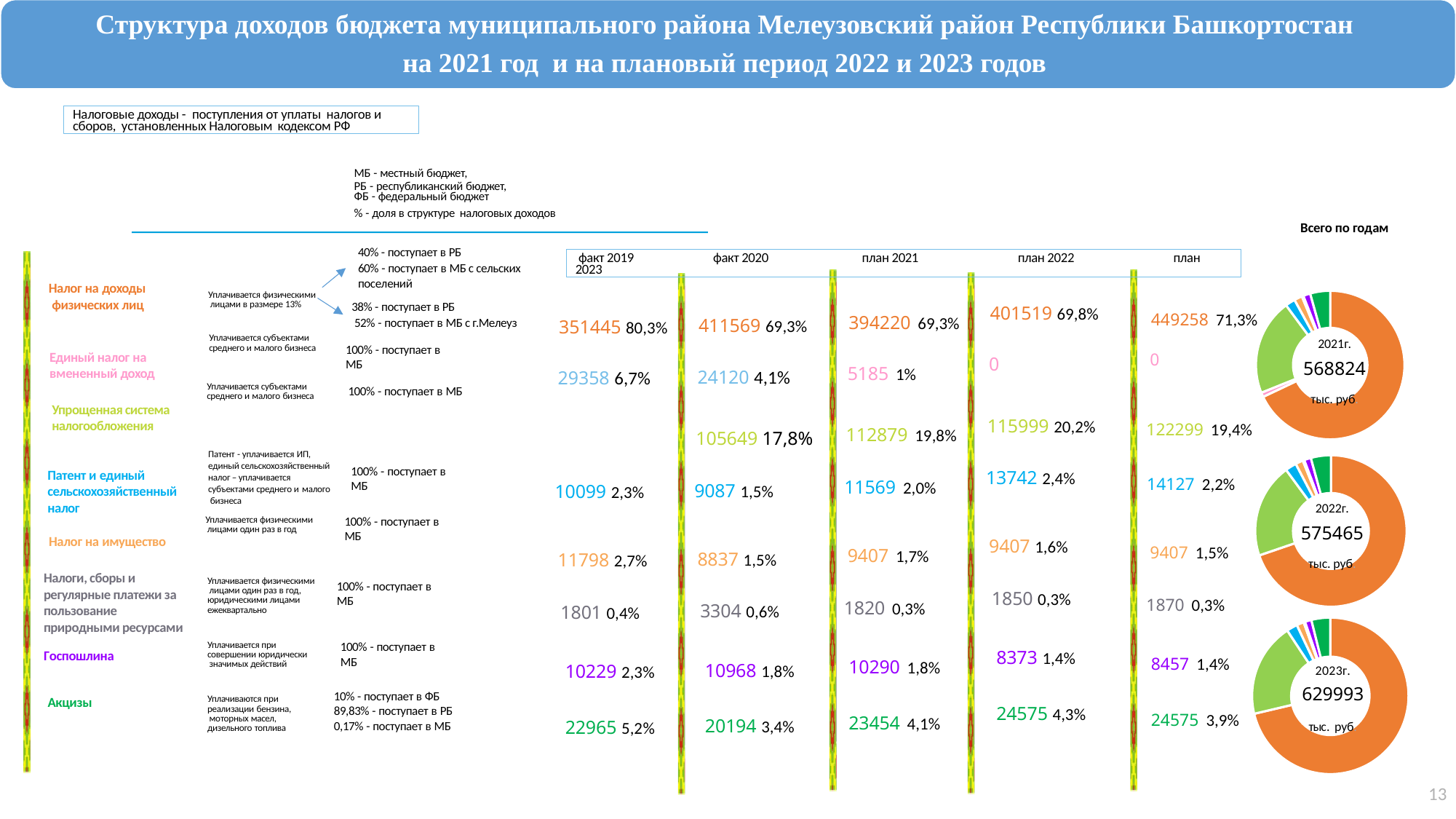
In the "Всего по годам" charts, what is the difference between the 2023г. total and the 2022г. total? 54528 What unit is printed in the centre of each "Всего по годам" donut chart? тыс. руб. In the "Всего по годам" charts, what total is shown in the centre of the 2022г. donut? 575465 What kind of chart is used in the "Всего по годам" section on the right of the slide? pie (donut) chart In the "Всего по годам" charts, which total is larger: 2021г. or 2022г.? 2022г. How many donut charts are shown in the "Всего по годам" section? 3 In the "Всего по годам" charts, what total is shown in the centre of the 2021г. donut? 568824 Among the three "Всего по годам" donut charts, which year has the highest total? 2023г. Among the three "Всего по годам" donut charts, which year has the lowest total? 2021г. In the "Всего по годам" charts, what total is shown in the centre of the 2023г. donut? 629993 In the "Всего по годам" charts, what is the difference between the 2023г. total and the 2021г. total? 61169 Do the totals in the "Всего по годам" donut charts rise or fall from 2021г. to 2023г.? rise